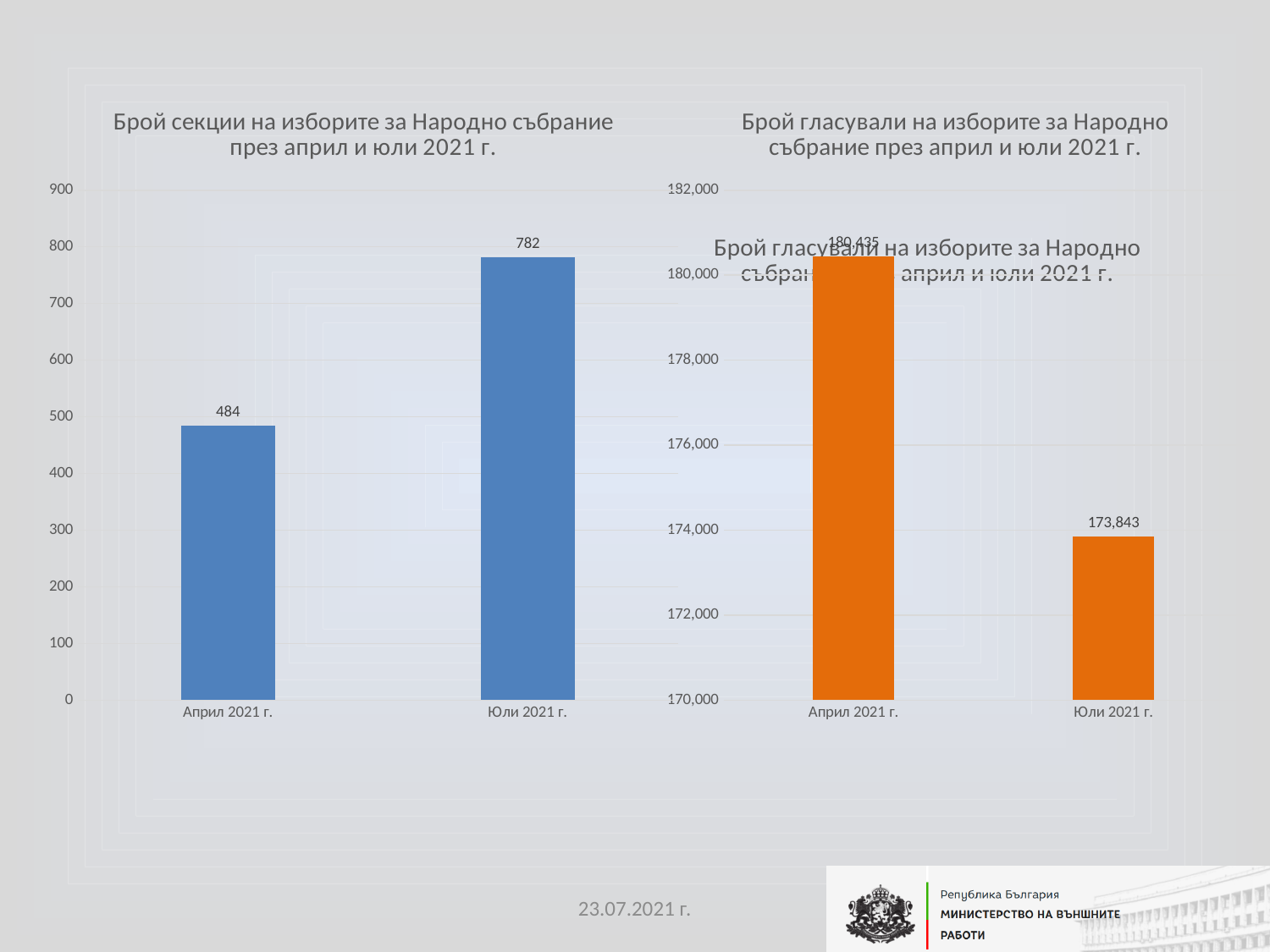
In the right chart (Брой гласували на изборите за Народно събрание), what is the value for Юли 2021 г.? 173,843 In the right chart (Брой гласували), is the value for Април 2021 г. greater or less than 180,000? greater In the left chart (Брой секции), which category has the higher value? Юли 2021 г. How many categories are shown in the left chart (Брой секции)? 2 In the right chart (Брой гласували), which category has the lower value? Юли 2021 г. In the right chart (Брой гласували), do the values rise or fall from Април 2021 г. to Юли 2021 г.? fall In the right chart (Брой гласували), is the value for Юли 2021 г. greater or less than 174,000? less In the left chart (Брой секции на изборите за Народно събрание), what is the value for Юли 2021 г.? 782 In the left chart (Брой секции), what is the difference between the values for Юли 2021 г. and Април 2021 г.? 298 In the left chart (Брой секции), is the value for Април 2021 г. greater or less than 500? less In the left chart (Брой секции на изборите за Народно събрание), what is the value for Април 2021 г.? 484 What type of chart is the right chart (Брой гласували)? bar chart